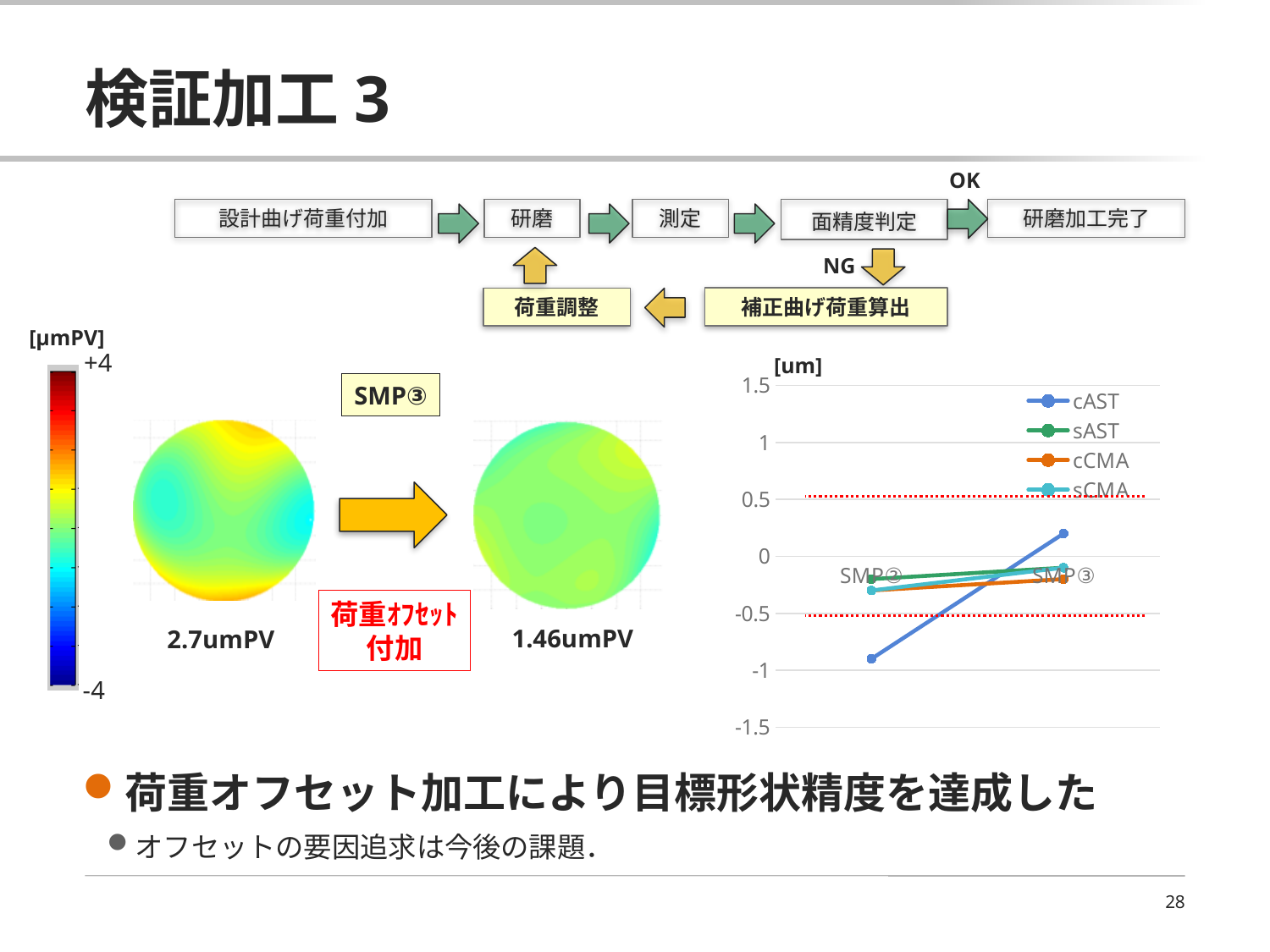
In the line chart, is the sAST value at SMP② greater or less than -0.5? greater What kind of chart is shown on the right side of the slide? line chart What unit label is shown above the y-axis of the line chart? [um] In the line chart, is the cAST value at SMP③ greater or less than 0? greater How many x-axis categories does the line chart have? 2 How many series does the legend of the line chart list? 4 In the line chart, which series has the lowest value at SMP②? cAST What are the series names listed in the legend of the line chart? cAST, sAST, cCMA, sCMA In the line chart, which is larger at SMP②: the cAST value or the sAST value? sAST In the line chart, is the cAST value at SMP② greater or less than -0.5? less In the line chart, which series has the highest value at SMP③? cAST In the line chart, does the cAST series rise or fall from SMP② to SMP③? rise